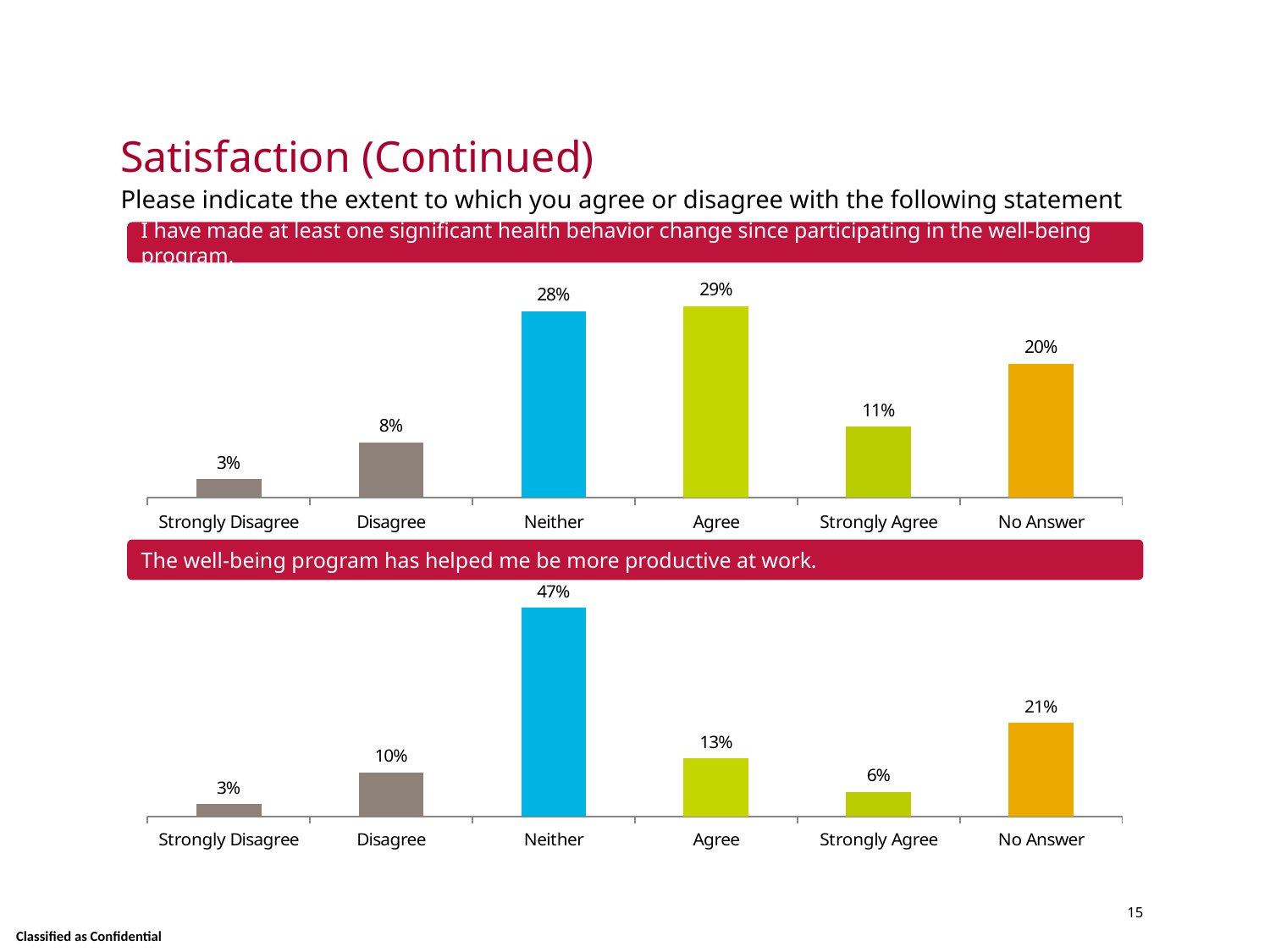
In the top chart (health behavior change), which response category has the highest percentage? Agree In the top chart (health behavior change), what percentage of respondents answered Strongly Agree? 11% What type of chart is used for the bottom chart (more productive at work)? Bar chart In the bottom chart (more productive at work), what is the difference between the Neither and Agree percentages? 34% In the top chart (health behavior change), what percentage of respondents answered Agree? 29% What colour is the Neither bar in the top chart (health behavior change)? Blue In the bottom chart (more productive at work), what percentage of respondents answered No Answer? 21% In the bottom chart (more productive at work), which response category has the lowest percentage? Strongly Disagree In the bottom chart (more productive at work), what percentage of respondents answered Neither? 47% In the top chart (health behavior change), what is the difference between the No Answer and Disagree percentages? 12% In the bottom chart (more productive at work), which is larger: the percentage for Agree or for Strongly Agree? Agree How many response categories are shown on the x axis of the top chart (health behavior change)? 6